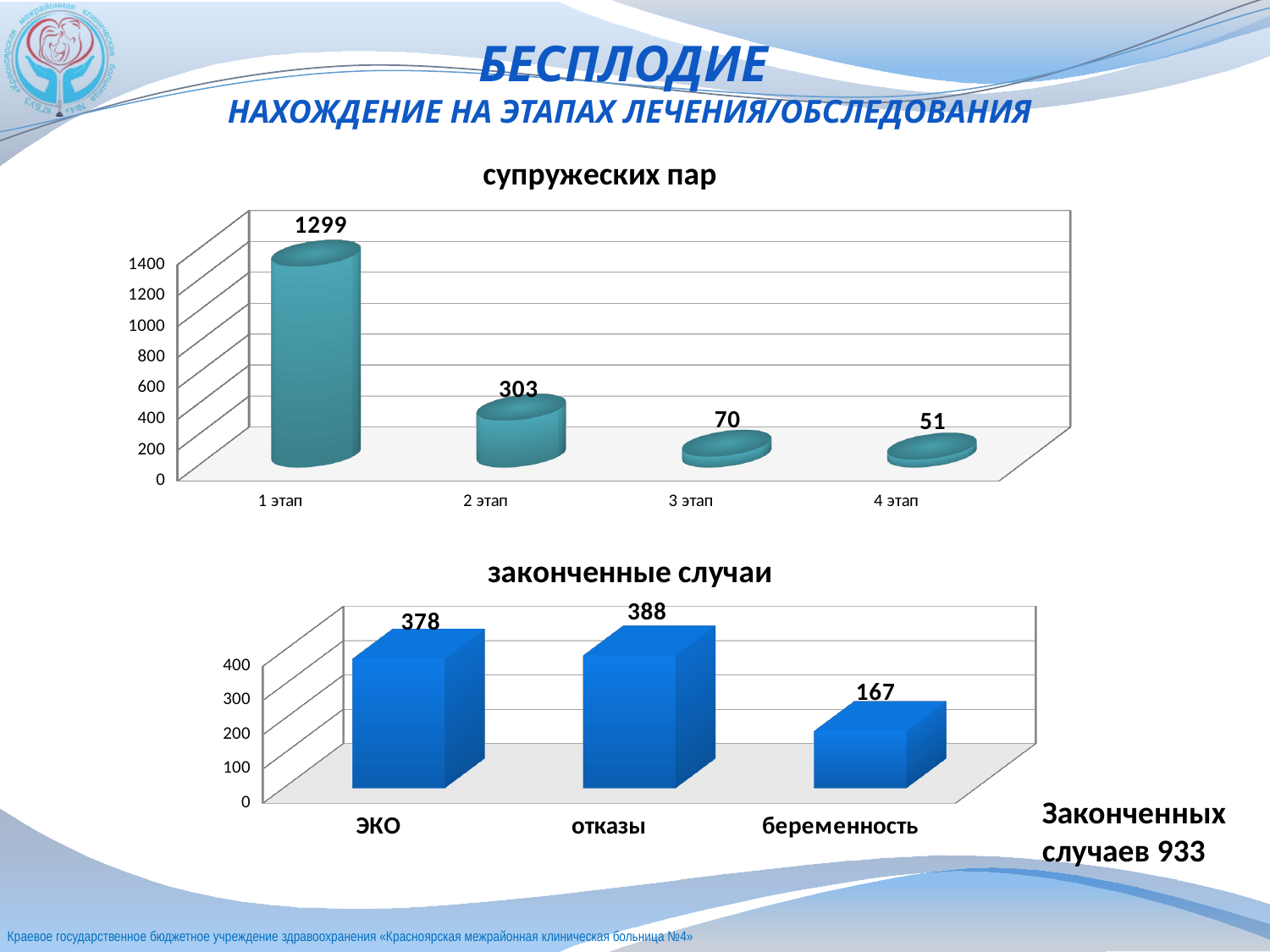
What kind of chart is the chart titled 'законченные случаи'? bar chart In the chart titled 'законченные случаи', how many categories are shown? 3 In the chart titled 'супружеских пар', what is the value for 3 этап? 70 In the chart titled 'супружеских пар', do the values rise or fall from 1 этап to 4 этап? fall In the chart titled 'законченные случаи', what is the difference between отказы and ЭКО? 10 In the chart titled 'супружеских пар', how many categories are shown? 4 In the chart titled 'законченные случаи', which is larger, ЭКО or беременность? ЭКО In the chart titled 'супружеских пар', what is the difference between 1 этап and 2 этап? 996 In the chart titled 'законченные случаи', which category has the highest value? отказы In the chart titled 'супружеских пар', what is the value for 1 этап? 1299 In the chart titled 'супружеских пар', which stage has the lowest value? 4 этап In the chart titled 'законченные случаи', what is the value for беременность? 167